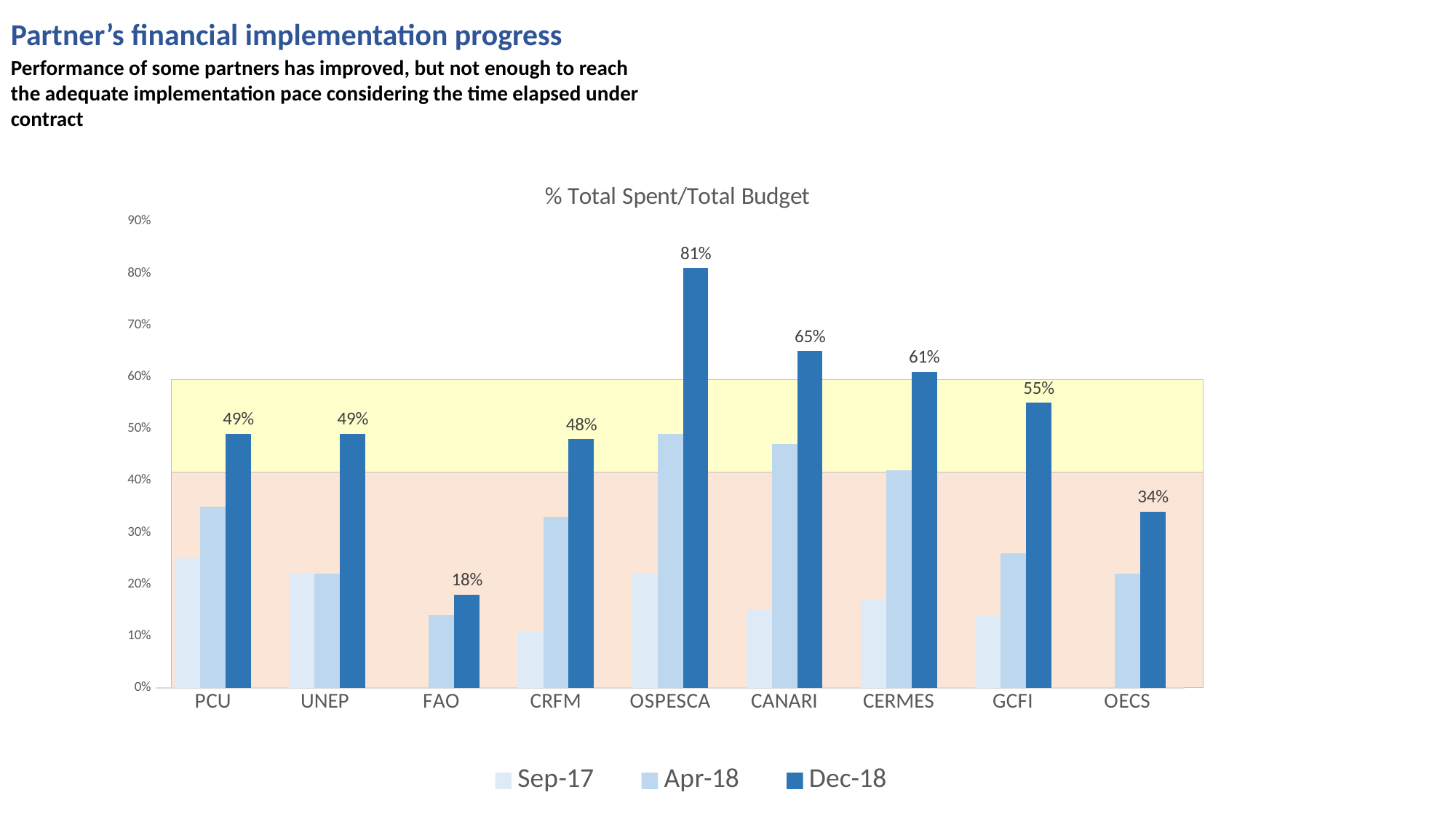
What is the Dec-18 value for OECS? 34% What is the Dec-18 value for OSPESCA? 81% What is the Dec-18 value for FAO? 18% Is the Sep-17 value for CRFM greater or less than 20%? less Is the Apr-18 value for OSPESCA greater or less than 40%? greater Which partner has the lowest Dec-18 value? FAO What type of chart is shown? Bar chart How many partners are shown on the x axis? 9 What is the difference between the Dec-18 values for OSPESCA and CANARI? 16% How many series does the legend list? 3 Which partner has the highest Dec-18 value? OSPESCA Which is larger, the Dec-18 value for CERMES or for GCFI? CERMES